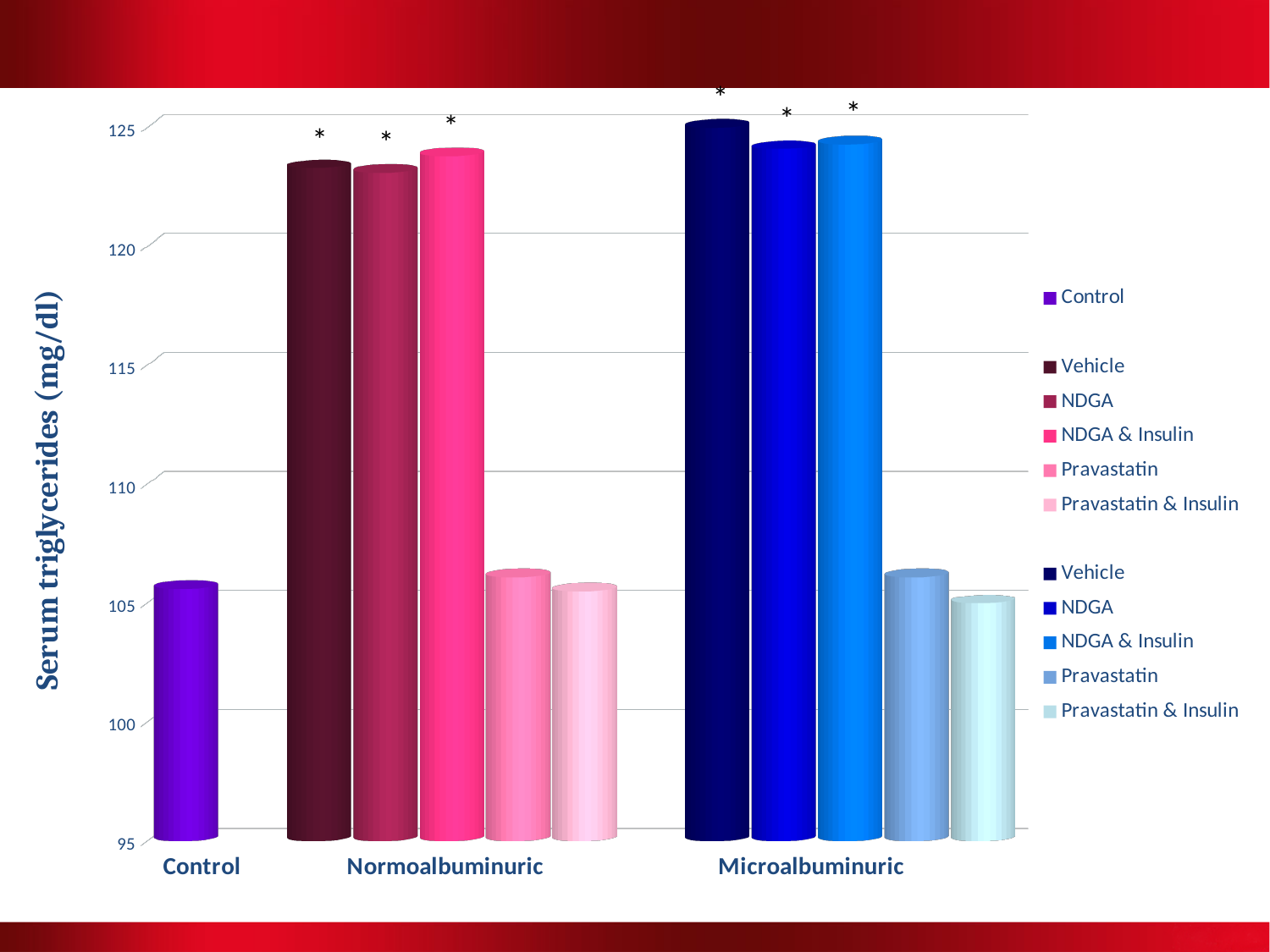
Which bar is the highest on the chart? Vehicle in the Microalbuminuric group Which is larger, the Vehicle bar in the Microalbuminuric group or the Vehicle bar in the Normoalbuminuric group? Vehicle in the Microalbuminuric group How many entries does the legend list? 11 What is the label of the y axis? Serum triglycerides (mg/dl) Is the value for the Control bar greater or less than 110? less How many bars are plotted in the Normoalbuminuric group? 5 Is the value for NDGA & Insulin in the Normoalbuminuric group greater or less than 115? greater Is the value for Vehicle in the Normoalbuminuric group greater or less than 120? greater What kind of chart is shown on the slide? bar chart How many categories are shown on the x axis? 3